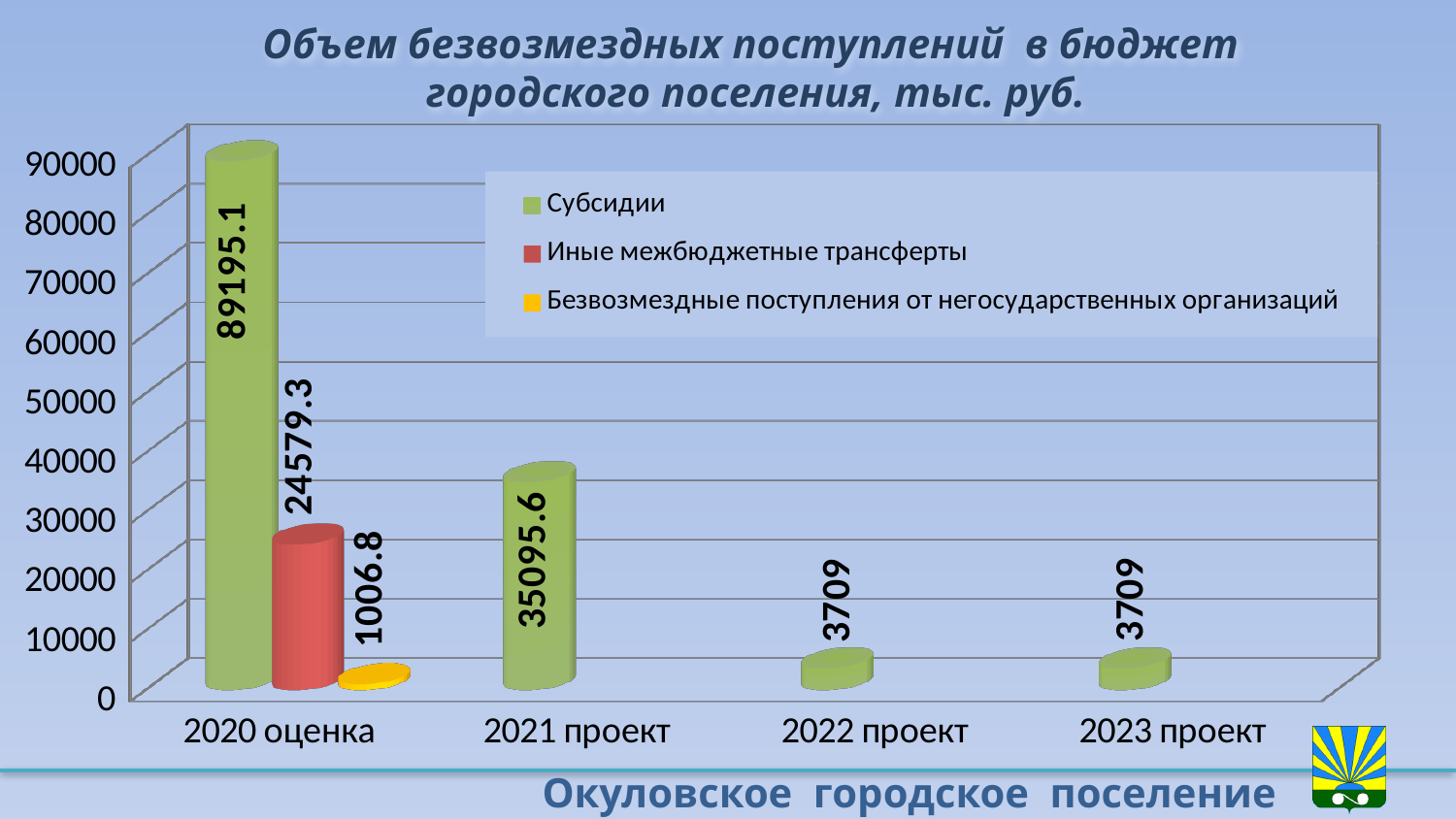
How many series does the legend list? 3 How many categories are shown on the x axis? 4 What kind of chart is shown on the slide? Bar chart What is the value of Безвозмездные поступления от негосударственных организаций for 2020 оценка? 1006.8 What is the value of Субсидии for 2021 проект? 35095.6 What is the value of Субсидии for 2020 оценка? 89195.1 What is the value of Иные межбюджетные трансферты for 2020 оценка? 24579.3 What is the difference between the Субсидии values for 2020 оценка and 2021 проект? 54099.5 Do the Субсидии values rise or fall from 2020 оценка to 2022 проект? Fall Which is larger for 2020 оценка: Иные межбюджетные трансферты or Безвозмездные поступления от негосударственных организаций? Иные межбюджетные трансферты What is the value of Субсидии for 2023 проект? 3709 Which category has the highest value of Субсидии? 2020 оценка